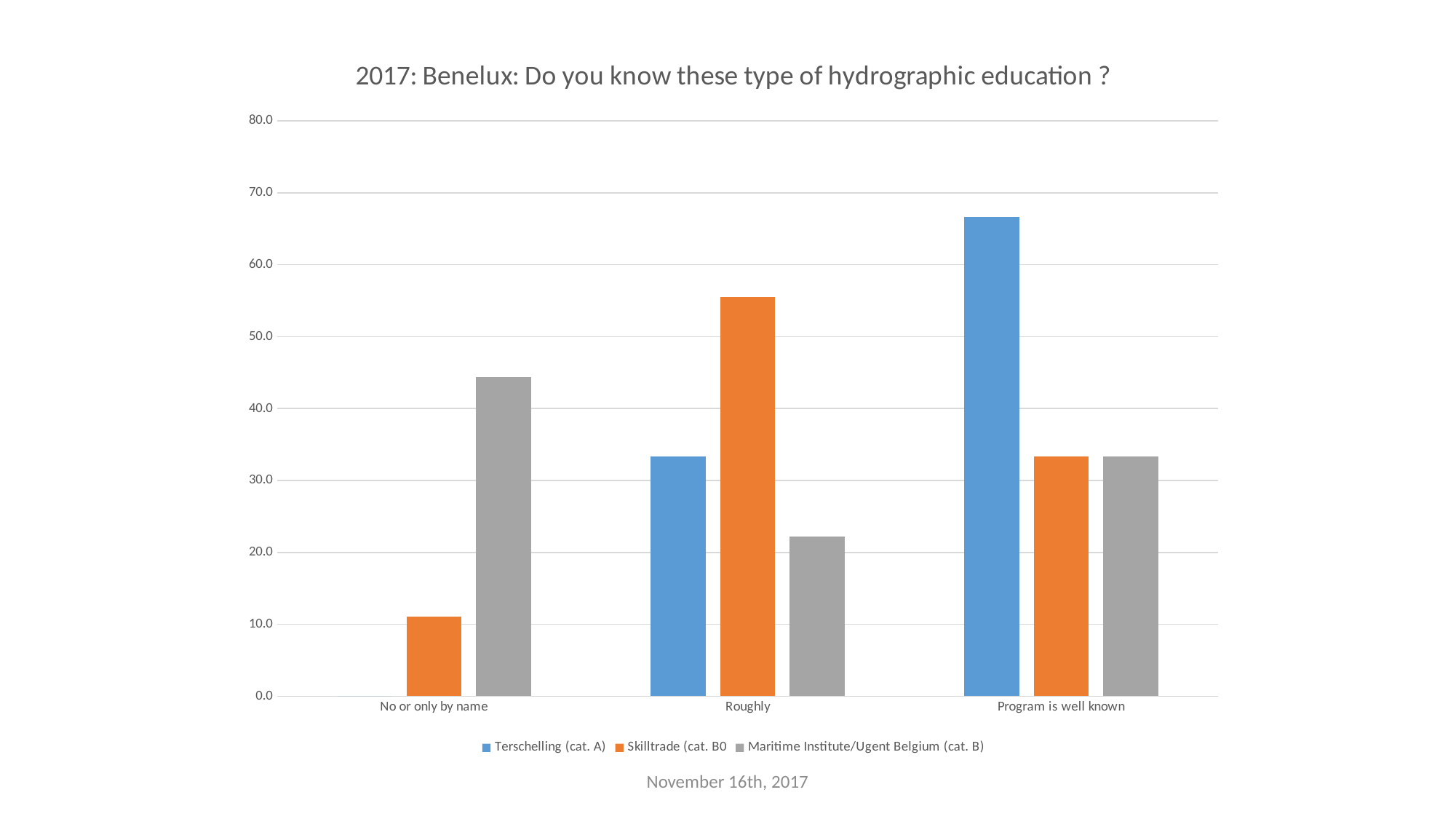
For which category is the Terschelling (cat. A) bar highest? Program is well known Is the value for Terschelling (cat. A) at Program is well known greater or less than 60? greater What is the title of the chart? 2017: Benelux: Do you know these type of hydrographic education ? Is the value for Skilltrade (cat. B0 at No or only by name greater or less than 20? less How many series does the legend list? 3 What kind of chart is shown on the slide? bar chart In the Roughly category, which is larger: Skilltrade (cat. B0 or Terschelling (cat. A)? Skilltrade (cat. B0 For which category is the Skilltrade (cat. B0 bar highest? Roughly Do the Terschelling (cat. A) values rise or fall from No or only by name to Program is well known? rise For which category is the Maritime Institute/Ugent Belgium (cat. B) bar highest? No or only by name How many categories are shown on the x axis? 3 Is the value for Maritime Institute/Ugent Belgium (cat. B) at Roughly greater or less than 30? less